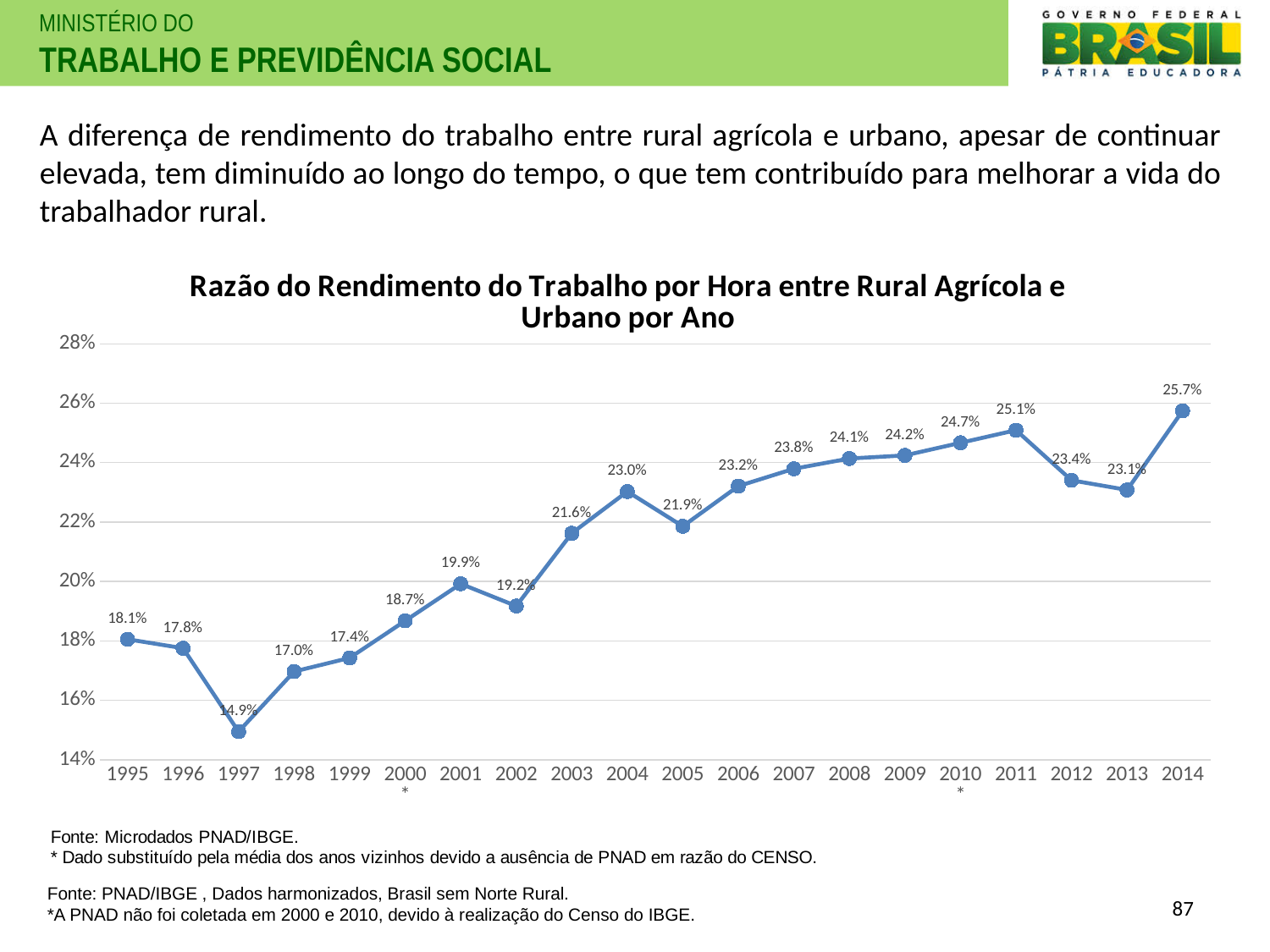
What is the value for 1997? 14.9% What is the value for 2004? 23.0% How many years are plotted on the chart? 20 What is the difference between the values for 2014 and 1995? 7.6% What kind of chart is shown? line chart Which is larger, the value for 2011 or the value for 2012? 2011 What is the title of the chart? Razão do Rendimento do Trabalho por Hora entre Rural Agrícola e Urbano por Ano Which year has the highest value? 2014 What is the value for 2014? 25.7% Which year has the lowest value? 1997 Is the value for 2003 greater or less than 22%? less Do the values generally rise or fall from 1995 to 2014? rise